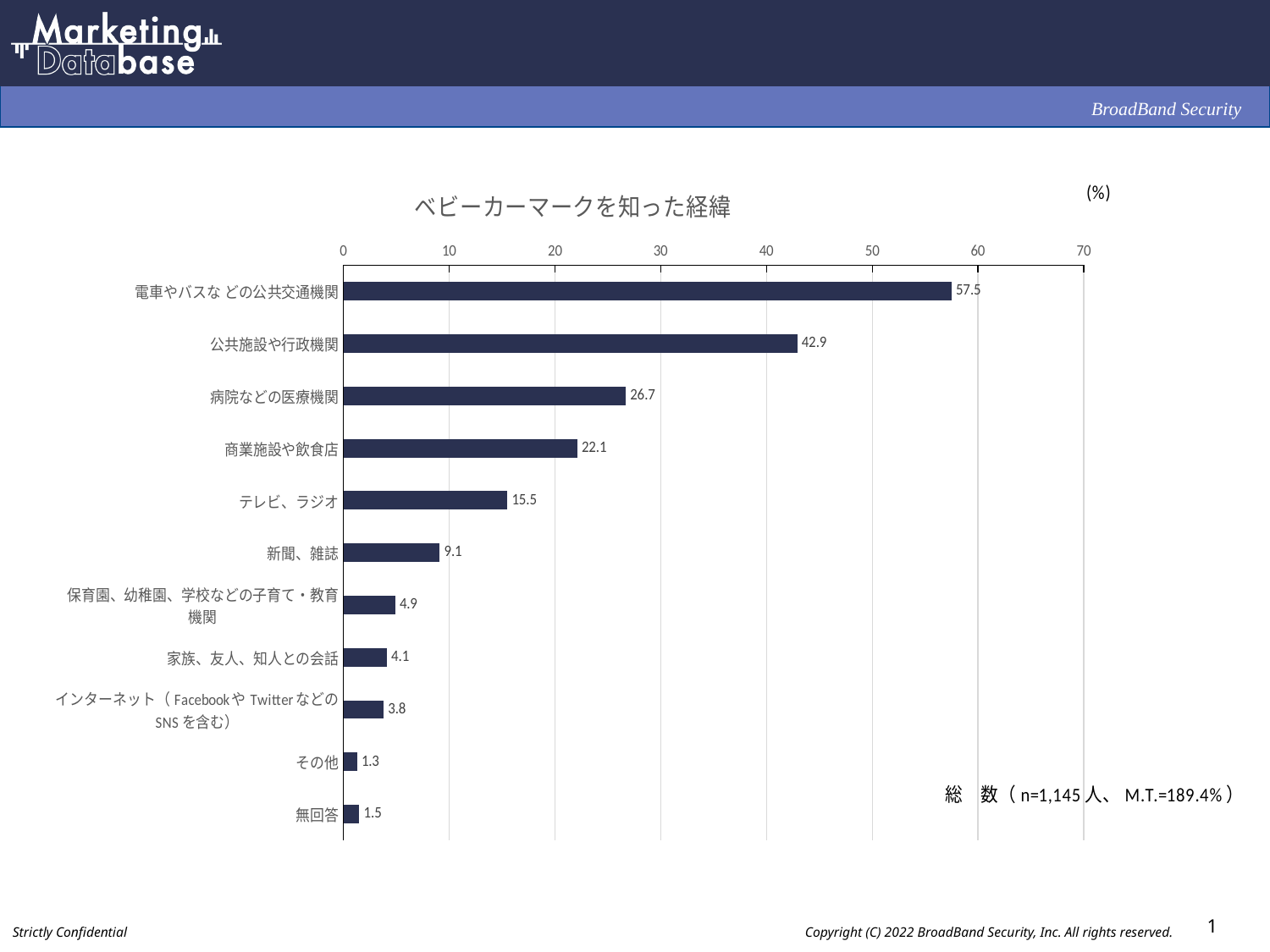
What is the value for 電車やバスなどの公共交通機関? 57.5 Is the value for 公共施設や行政機関 greater or less than 40? greater What is the value for 無回答? 1.5 What kind of chart is shown on the slide? bar chart What is the title of the chart? ベビーカーマークを知った経緯 What is the value for テレビ、ラジオ? 15.5 What is the value for 病院などの医療機関? 26.7 Which category has the highest value? 電車やバスなどの公共交通機関 Which is larger, the value for 商業施設や飲食店 or the value for 病院などの医療機関? 病院などの医療機関 Which category has the lowest value? その他 How many categories are shown in the chart? 11 What is the difference between the values for 電車やバスなどの公共交通機関 and 公共施設や行政機関? 14.6